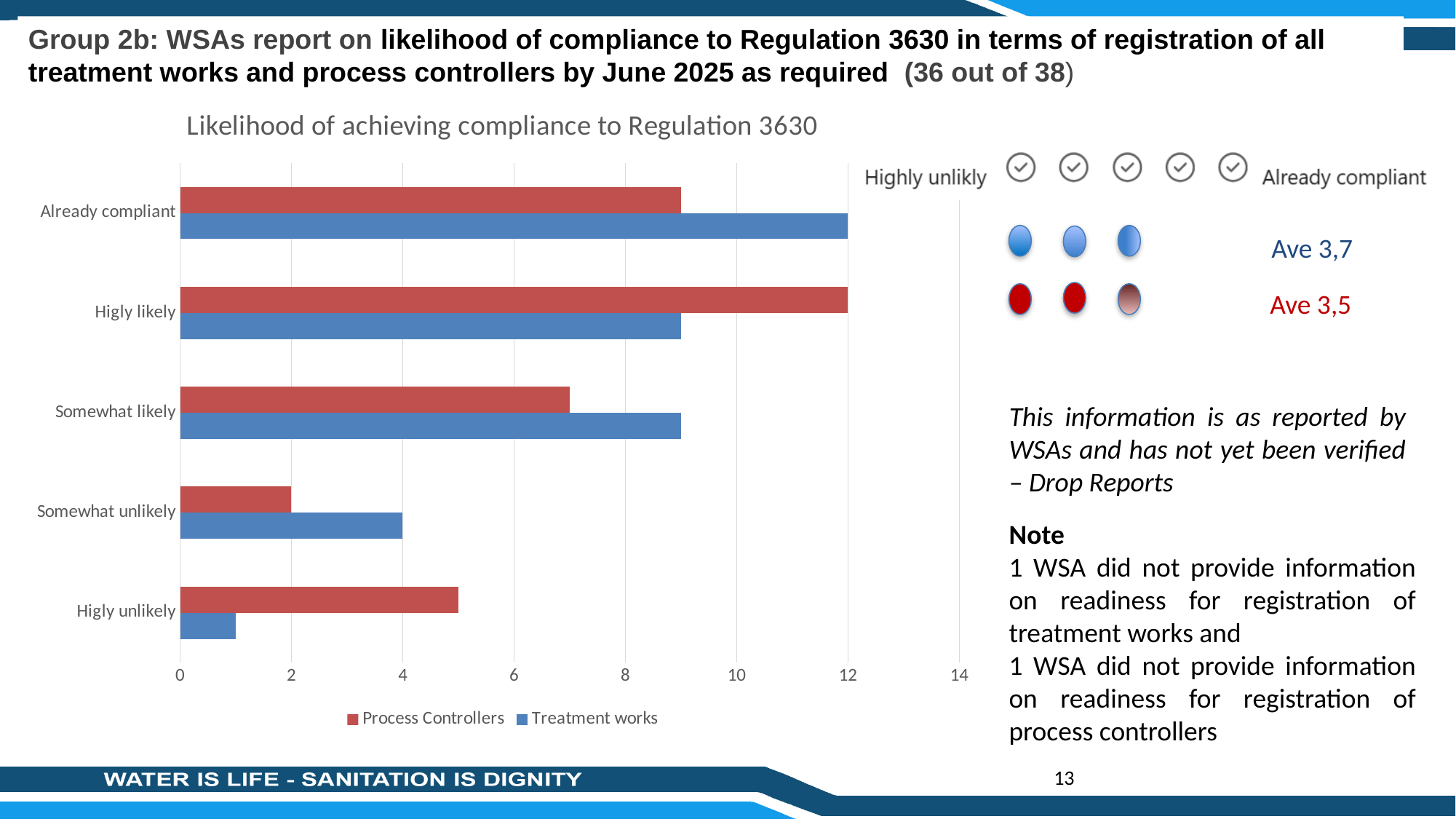
What is the value for Treatment works in the Already compliant category? 12 Is the value for Treatment works in the Higly unlikely category greater or less than 2? less How many series does the chart legend list? 2 How many categories are shown on the chart's vertical axis? 5 What is the value for Process Controllers in the Higly likely category? 12 Is the value for Process Controllers in the Higly unlikely category greater or less than 4? greater What kind of chart is shown on the slide? bar chart In the Somewhat likely category, which series has the larger value, Process Controllers or Treatment works? Treatment works What is the value for Process Controllers in the Somewhat unlikely category? 2 What is the title of the chart? Likelihood of achieving compliance to Regulation 3630 What is the value for Treatment works in the Somewhat unlikely category? 4 Which category has the lowest value for Treatment works? Higly unlikely